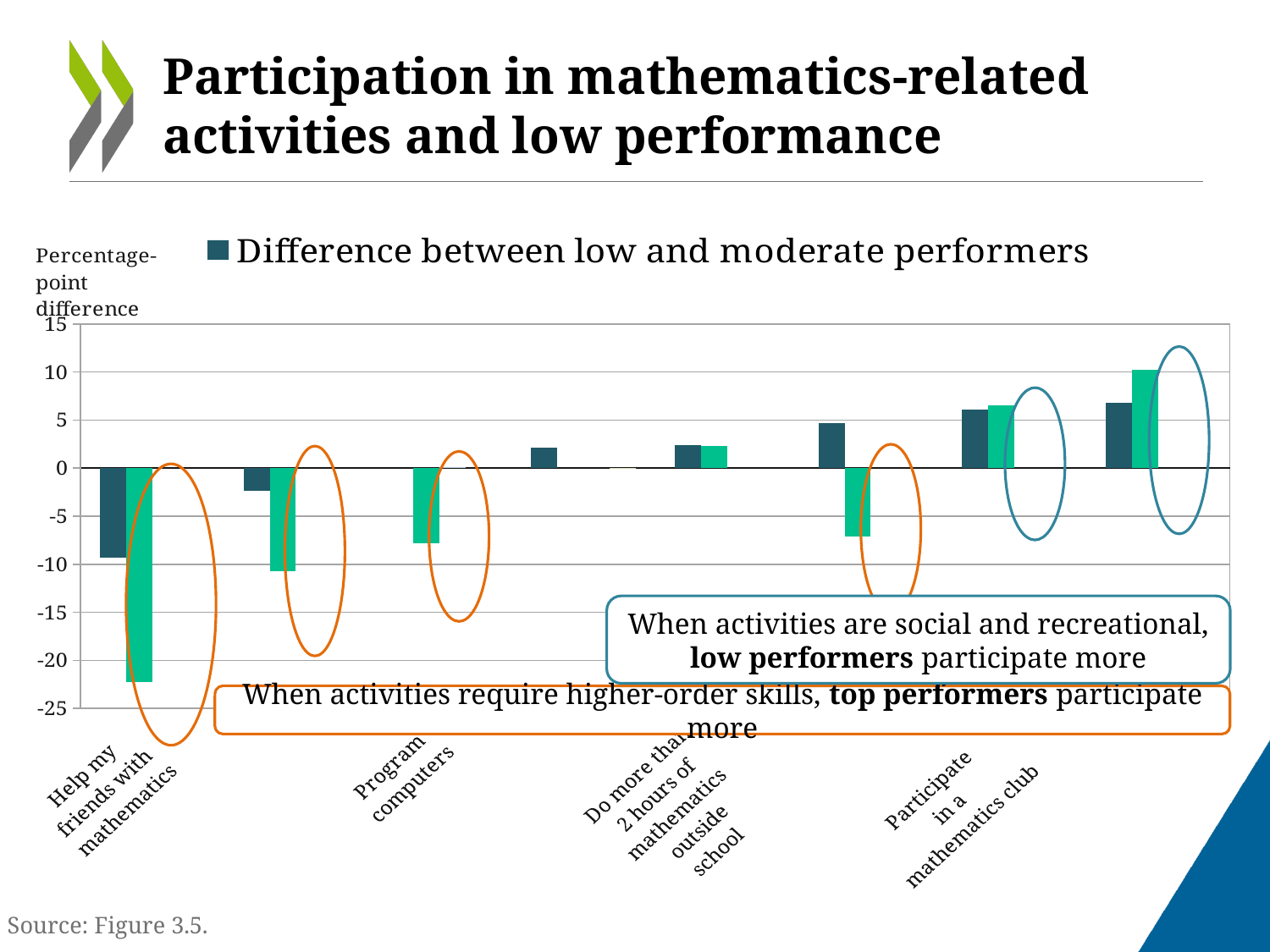
Is the green bar for 'Program computers' greater or less than -5? less Which labelled activity has the lowest green bar on the chart? Help my friends with mathematics What kind of chart is shown on the slide? bar chart Do the bar values generally rise or fall moving from left to right across the chart? rise How many groups of bars are plotted on the chart? 8 Is the dark teal bar for 'Do more than 2 hours of mathematics outside school' greater or less than 0? greater Which has the larger green bar: 'Participate in a mathematics club' or 'Do more than 2 hours of mathematics outside school'? Participate in a mathematics club Is the green bar for 'Participate in a mathematics club' greater or less than 5? greater What is the legend entry shown above the chart? Difference between low and moderate performers What is the label on the vertical axis of the chart? Percentage-point difference Which labelled activity has the highest green bar on the chart? Participate in a mathematics club